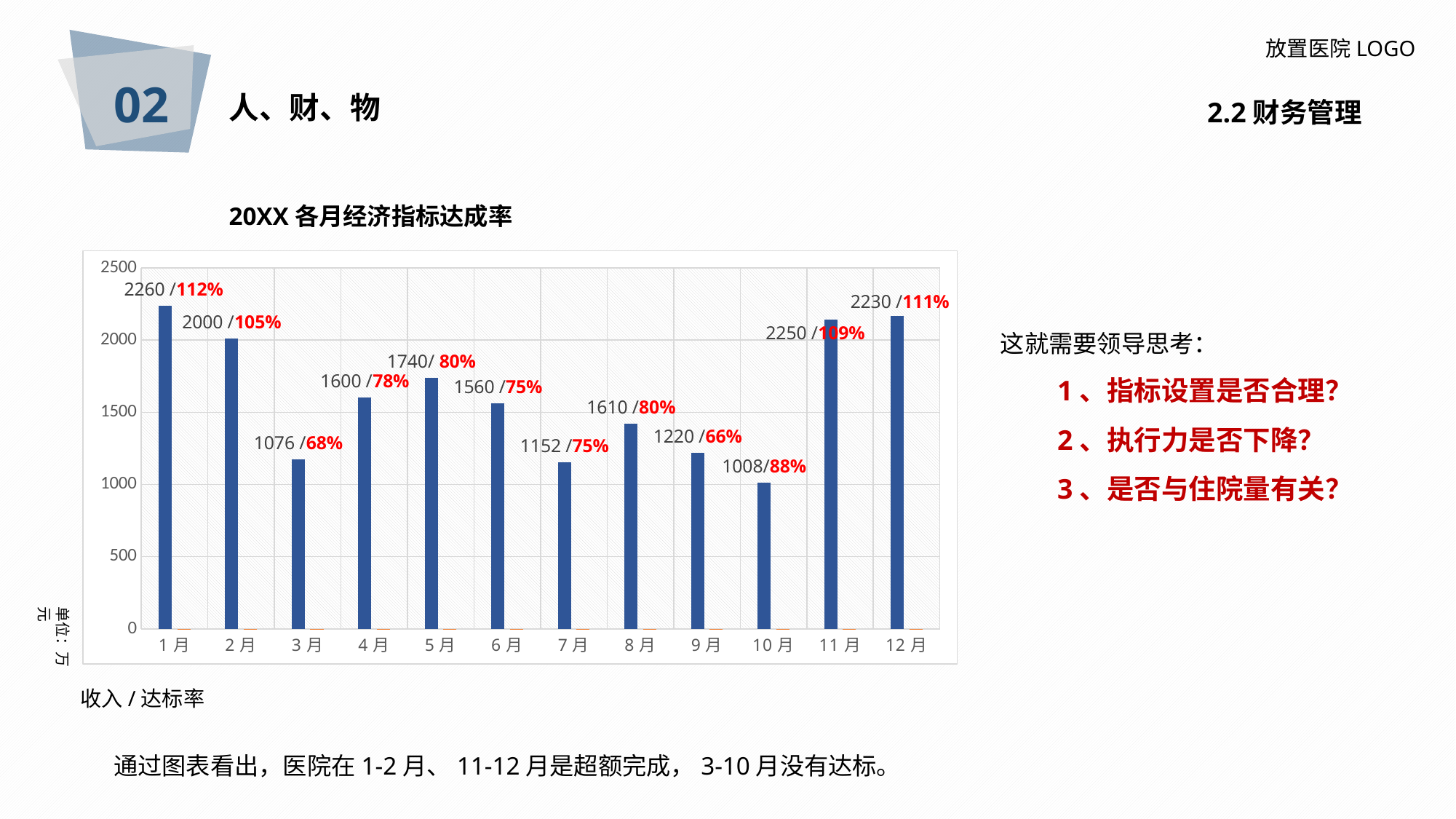
How many months are shown on the x axis? 12 What achievement rate is shown for 11月? 109% What is the title of the chart? 20XX 各月经济指标达成率 What is the income value shown for 10月? 1008 Which month has the highest income value? 1月 Which has a larger income value, 5月 or 6月? 5月 What achievement rate is shown for 3月? 68% Which month has the lowest income value? 10月 What kind of chart is shown on the slide? bar chart What is the difference between the income values for 1月 and 10月? 1252 Is the income value for 9月 greater or less than 1500? less What is the income value shown for 1月? 2260